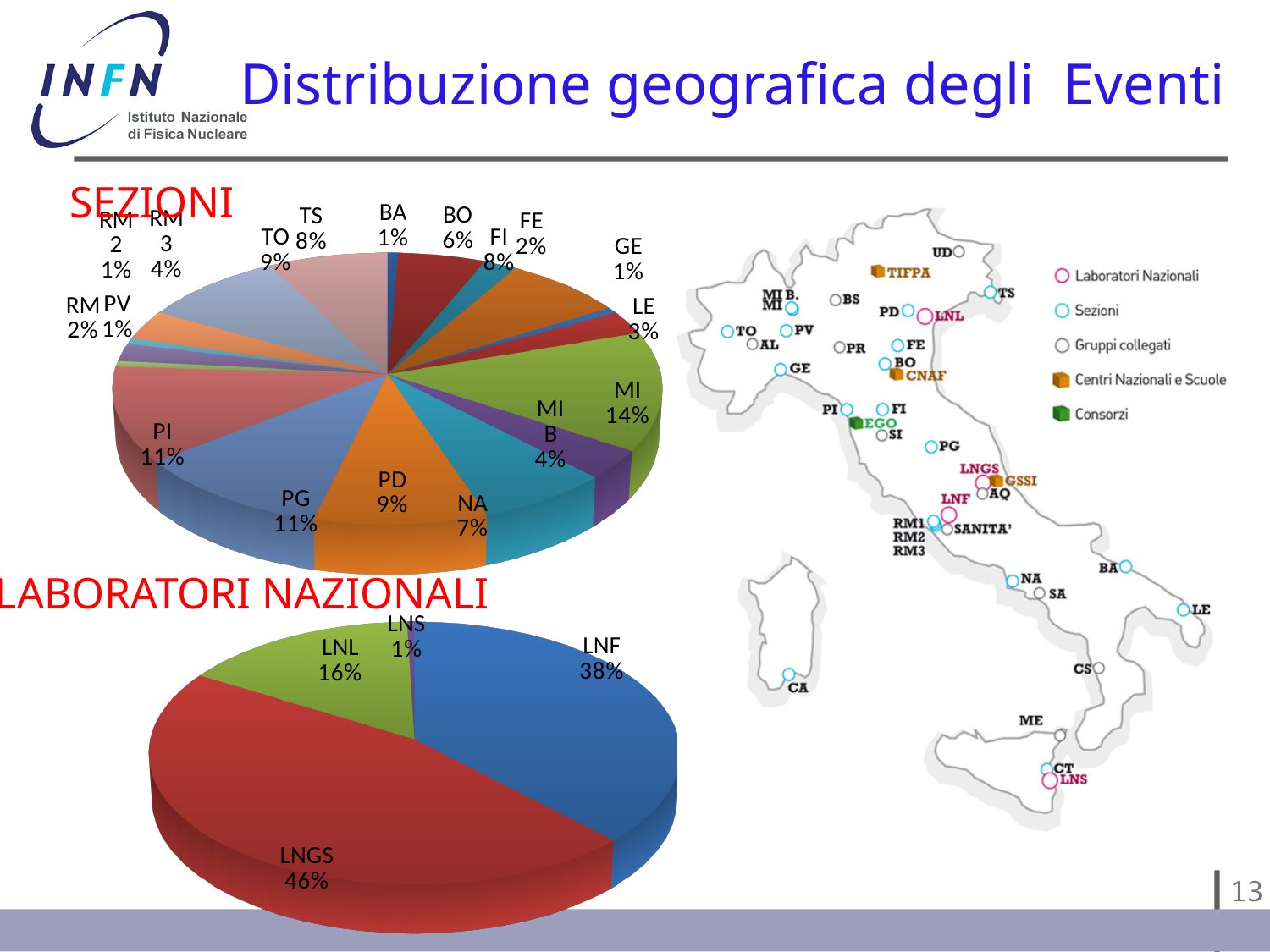
In the SEZIONI pie chart, which has the larger share, PD or NA? PD In the LABORATORI NAZIONALI pie chart, what percentage is shown for LNGS? 46% In the LABORATORI NAZIONALI pie chart, what percentage is shown for LNL? 16% In the SEZIONI pie chart, what percentage is shown for MI? 14% In the SEZIONI pie chart, which section has the largest share? MI In the LABORATORI NAZIONALI pie chart, what percentage is shown for LNF? 38% In the LABORATORI NAZIONALI pie chart, how many percentage points larger is LNGS than LNF? 8 percentage points In the LABORATORI NAZIONALI pie chart, which laboratory has the smallest share? LNS In the LABORATORI NAZIONALI pie chart, which laboratory has the largest share? LNGS In the SEZIONI pie chart, what percentage is shown for PG? 11% How many slices does the LABORATORI NAZIONALI pie chart have? 4 What type of chart is used for the SEZIONI data? Pie chart